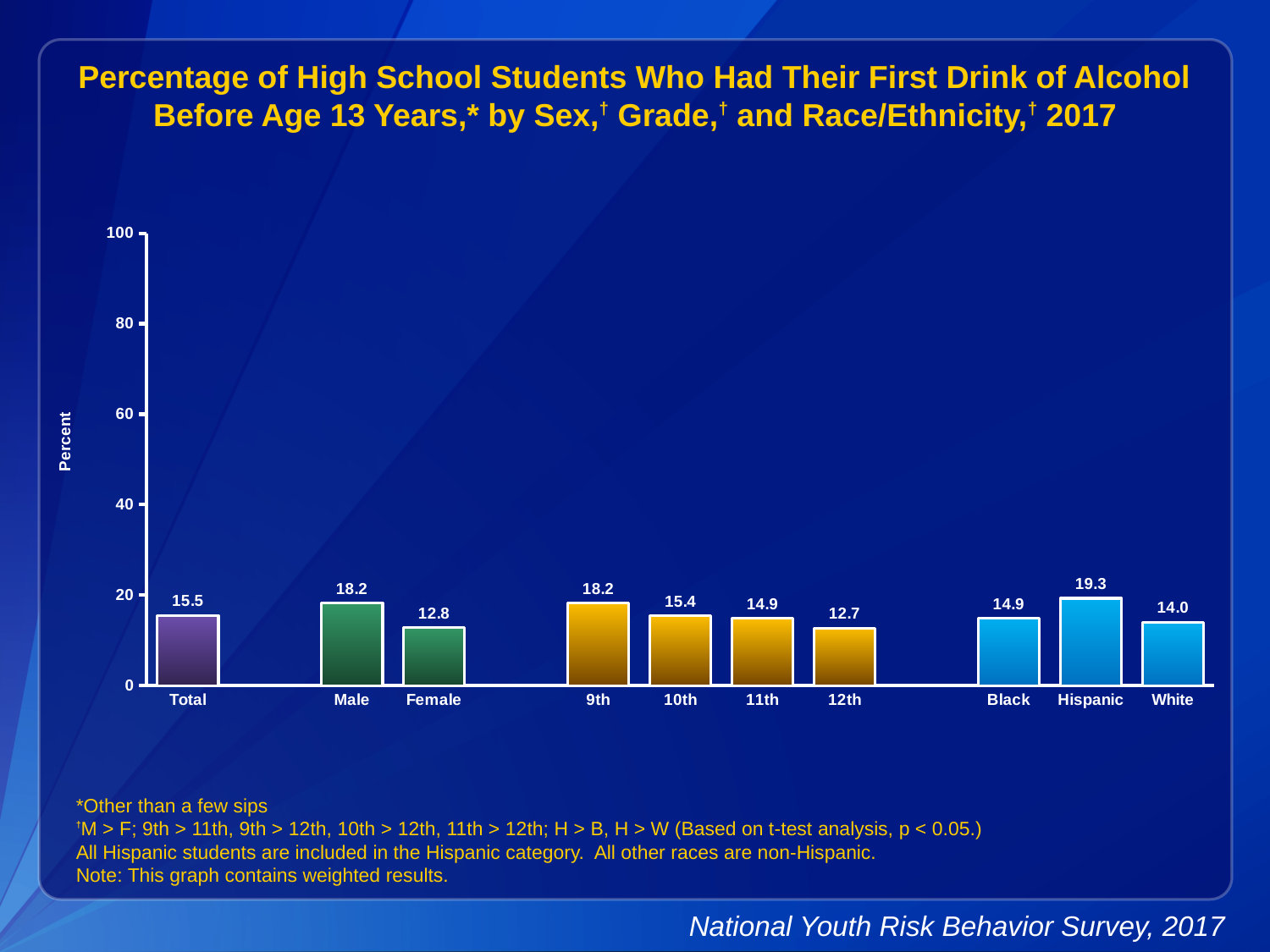
What is the difference between the Male and Female values? 5.4 What is the value for 12th grade? 12.7 How many bars are shown in the chart? 10 What is the value for Hispanic? 19.3 Do the values fall or rise from 9th grade to 12th grade? fall Which category has the highest value? Hispanic What is the value for Total? 15.5 Which category has the lowest value? 12th What is the value for Female? 12.8 What kind of chart is shown? bar chart Is the value for 9th grade greater or less than 20? less Which is larger, the value for Black or the value for White? Black